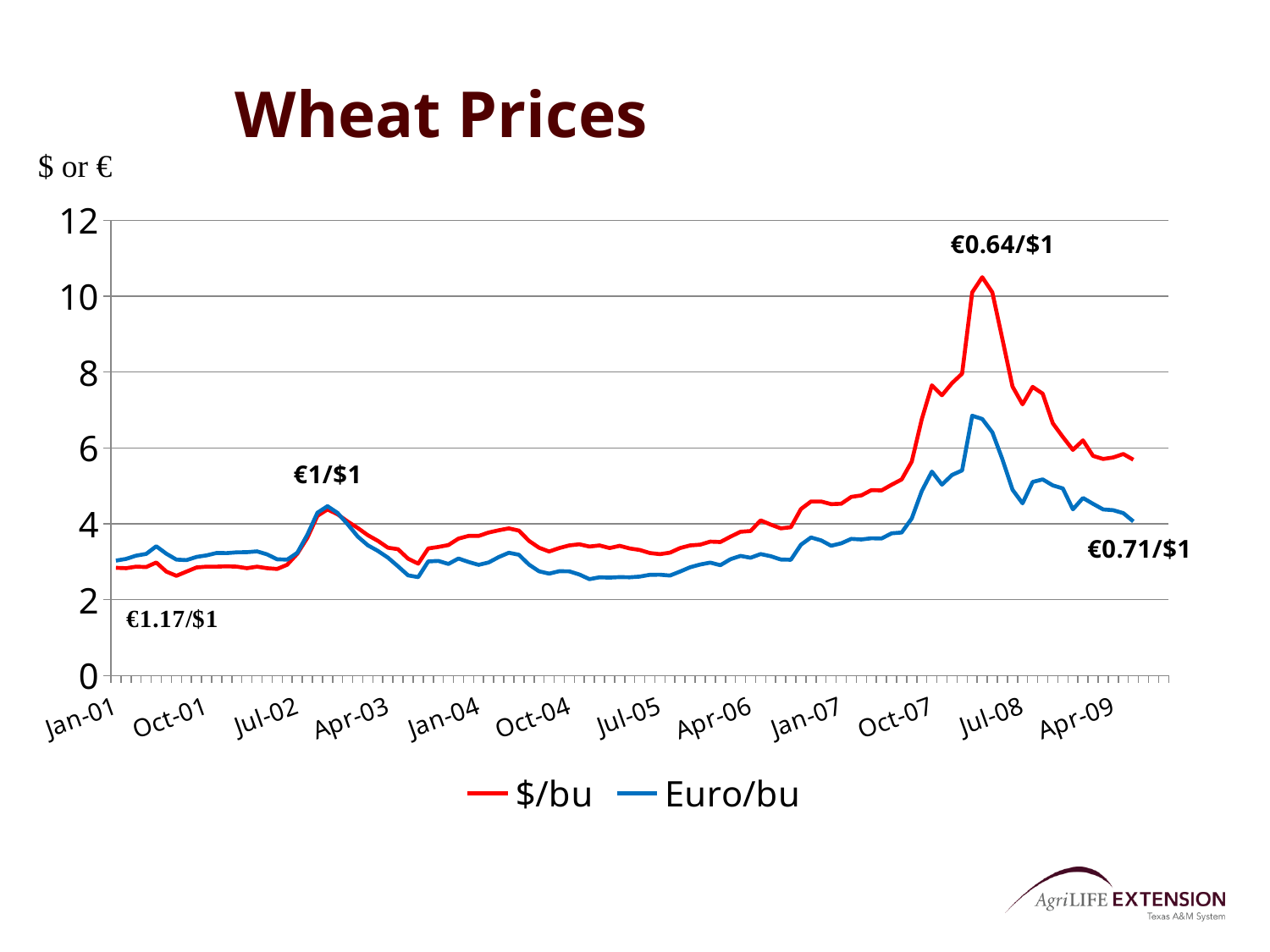
What kind of chart is shown on the slide? Line chart Is the peak value of the $/bu series greater or less than 8? greater How many series does the legend list? 2 Do the $/bu values rise or fall between Jul-08 and Apr-09? fall Which series reaches the highest value on the chart? $/bu What exchange-rate annotation is printed above the peak of the lines in 2008? €0.64/$1 Around which x-axis label does the $/bu series reach its peak? Jul-08 Is the peak value of the Euro/bu series greater or less than 6? greater Is the value of the Euro/bu series at Apr-09 greater or less than 6? less What are the two series named in the legend? $/bu and Euro/bu At Jul-08, which series has the higher value, $/bu or Euro/bu? $/bu